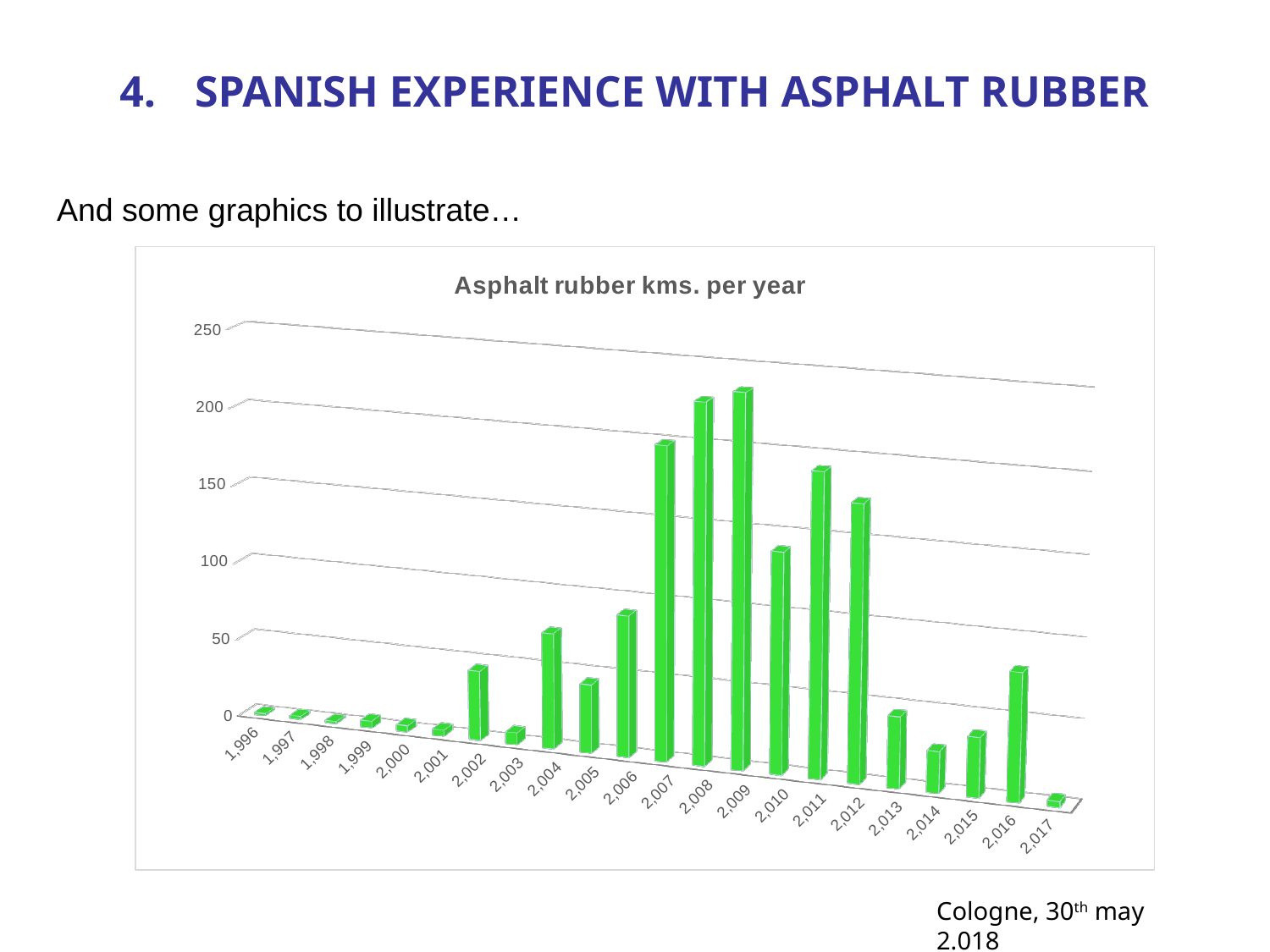
Is the value for 2016 greater or less than 50? greater Is the value for 2007 greater or less than 150? greater Is the value for 2010 greater or less than 150? less Which year has the larger value, 2007 or 2012? 2007 How many years are shown on the x axis of the chart? 22 Do the values rise or fall from 2009 to 2014? fall What kind of chart is shown on the slide? bar chart What is the title of the chart? Asphalt rubber kms. per year What colour are the bars in the chart? green Which year has the larger value, 2011 or 2010? 2011